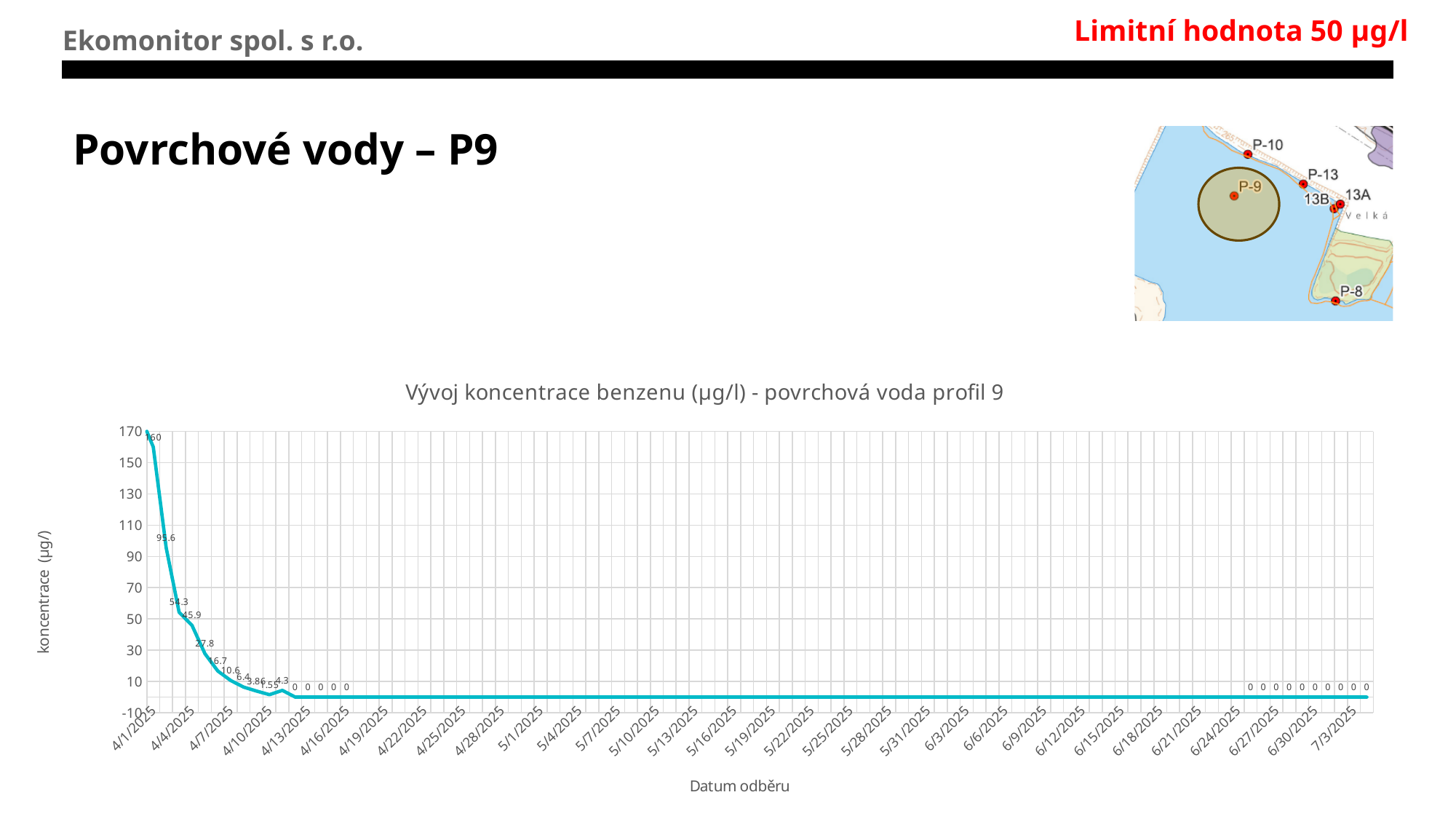
What is the value plotted for 7/3/2025? 0 Is the value for 4/1/2025 greater or less than 150? greater What is the lowest value plotted on the chart? 0 What is the difference between the first plotted value (160) and the second plotted value (95.6)? 64.4 How many data series are plotted on the chart? 1 Do the values rise or fall along the x axis from 4/1/2025 onward? fall What is the highest value plotted on the chart? 160 What kind of chart is shown on the slide? line chart Which is larger, the first plotted value or the second plotted value? the first plotted value (160) What is the label of the vertical axis of the chart? koncentrace (µg/l) What is the title of the chart? Vývoj koncentrace benzenu (µg/l) - povrchová voda profil 9 What is the benzene concentration value plotted for 4/1/2025? 160